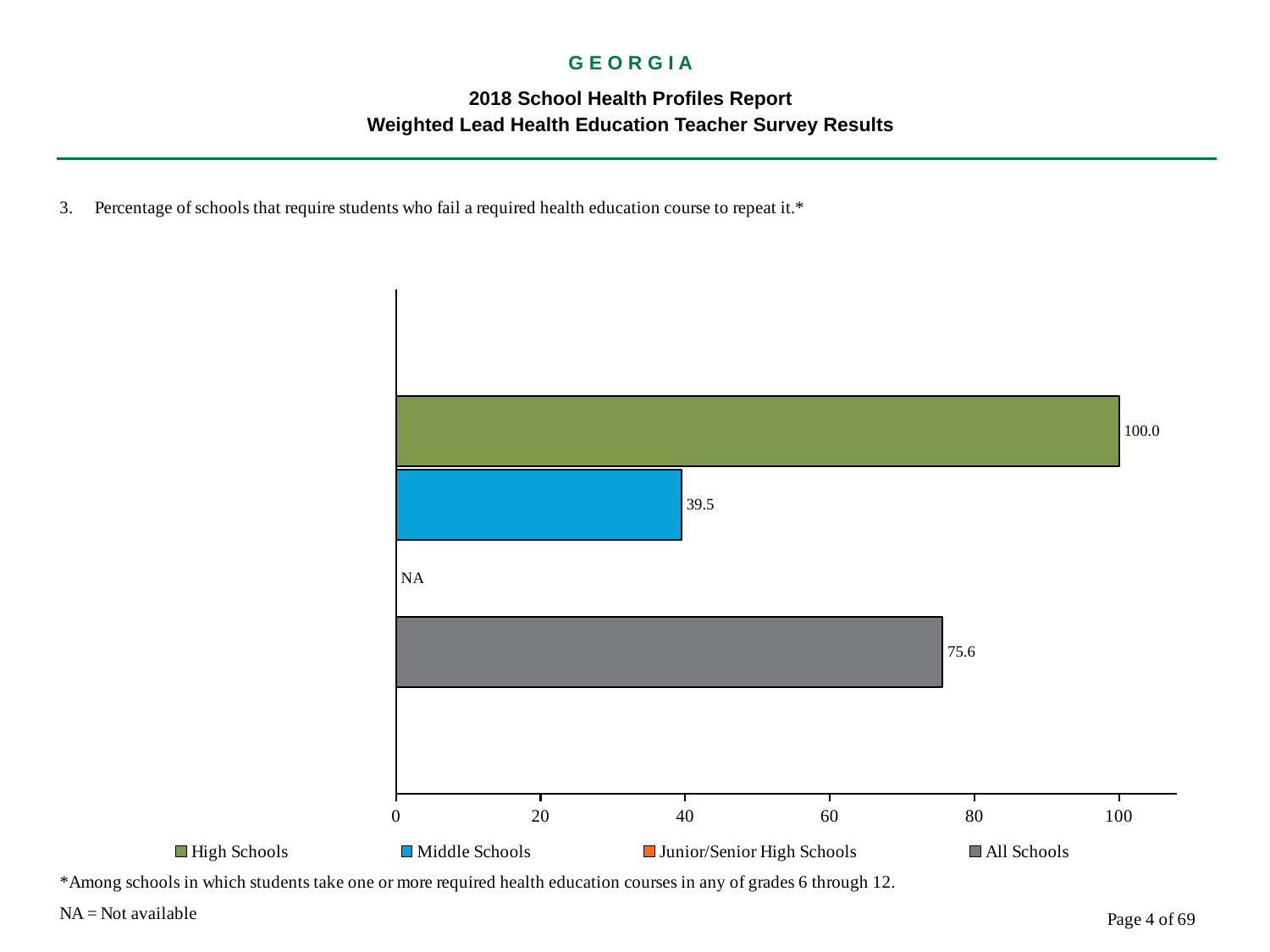
How many series does the legend list? 4 What is the difference between the High Schools and Middle Schools values? 60.5 Which school type has the highest value? High Schools What is the difference between the All Schools and Middle Schools values? 36.1 Is the value for All Schools greater or less than 80? less What kind of chart is shown on the slide? bar chart What is the value for High Schools? 100.0 What is the value for All Schools? 75.6 What is the value for Middle Schools? 39.5 What is shown for Junior/Senior High Schools? NA Which is larger, the value for All Schools or the value for Middle Schools? All Schools Which school type with a plotted bar has the lowest value? Middle Schools